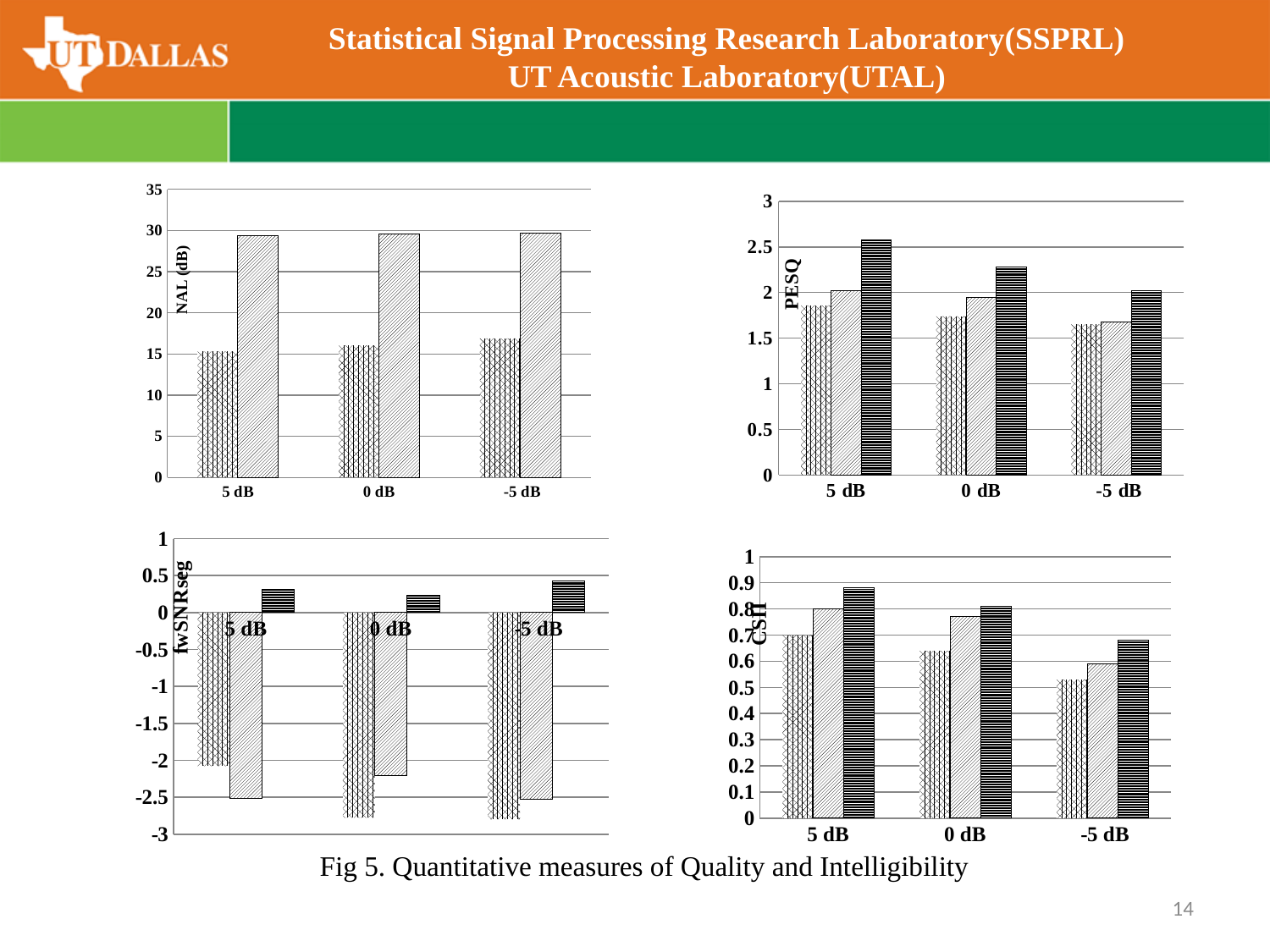
In the CSII chart, which category has the lowest bars? -5 dB In the PESQ chart, which category has the highest bar overall? 5 dB In the PESQ chart, how many categories are shown on the x axis? 3 In the PESQ chart, does the tallest bar in each group rise or fall going from 5 dB to -5 dB? fall How many charts are shown on the slide? 4 In the fwSNRseg chart, how many bars have negative values? 6 In the PESQ chart, is the value of the tallest bar at 5 dB greater or less than 2.5? greater In the NAL (dB) chart, is the value of the first (leftmost) bar at 5 dB greater or less than 20? less In the fwSNRseg chart, is the value of the first (leftmost) bar at 0 dB greater or less than -2.5? less What kind of chart is the NAL (dB) chart in the top-left? bar chart